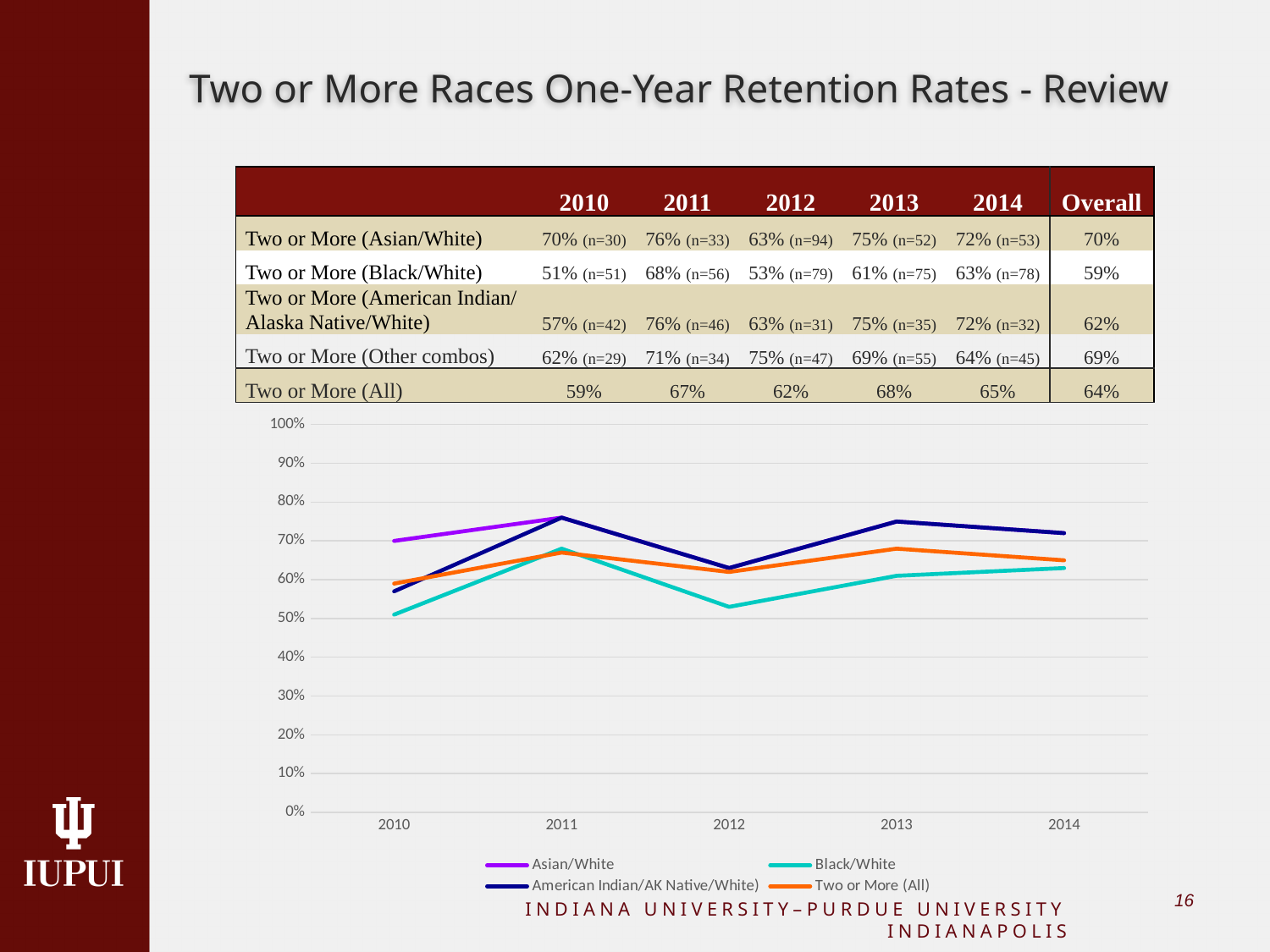
In which year is the Black/White retention rate lowest? 2010 How many years are plotted along the x axis of the chart? 5 What is the difference between the Asian/White and Black/White retention rates in 2010? 19% What is the Overall retention rate for Two or More (Asian/White)? 70% Does the Black/White retention rate rise or fall from 2012 to 2014? rise Which series has the lowest retention rate in 2010? Black/White Is the Black/White retention rate in 2012 greater or less than 60%? less What is the one-year retention rate for Two or More (All) in 2013? 68% Which is larger in 2012, the Two or More (All) rate or the Black/White rate? Two or More (All) What is the one-year retention rate for Two or More (Black/White) in 2012? 53% How many series does the chart legend list? 4 What kind of chart is shown on the slide? line chart